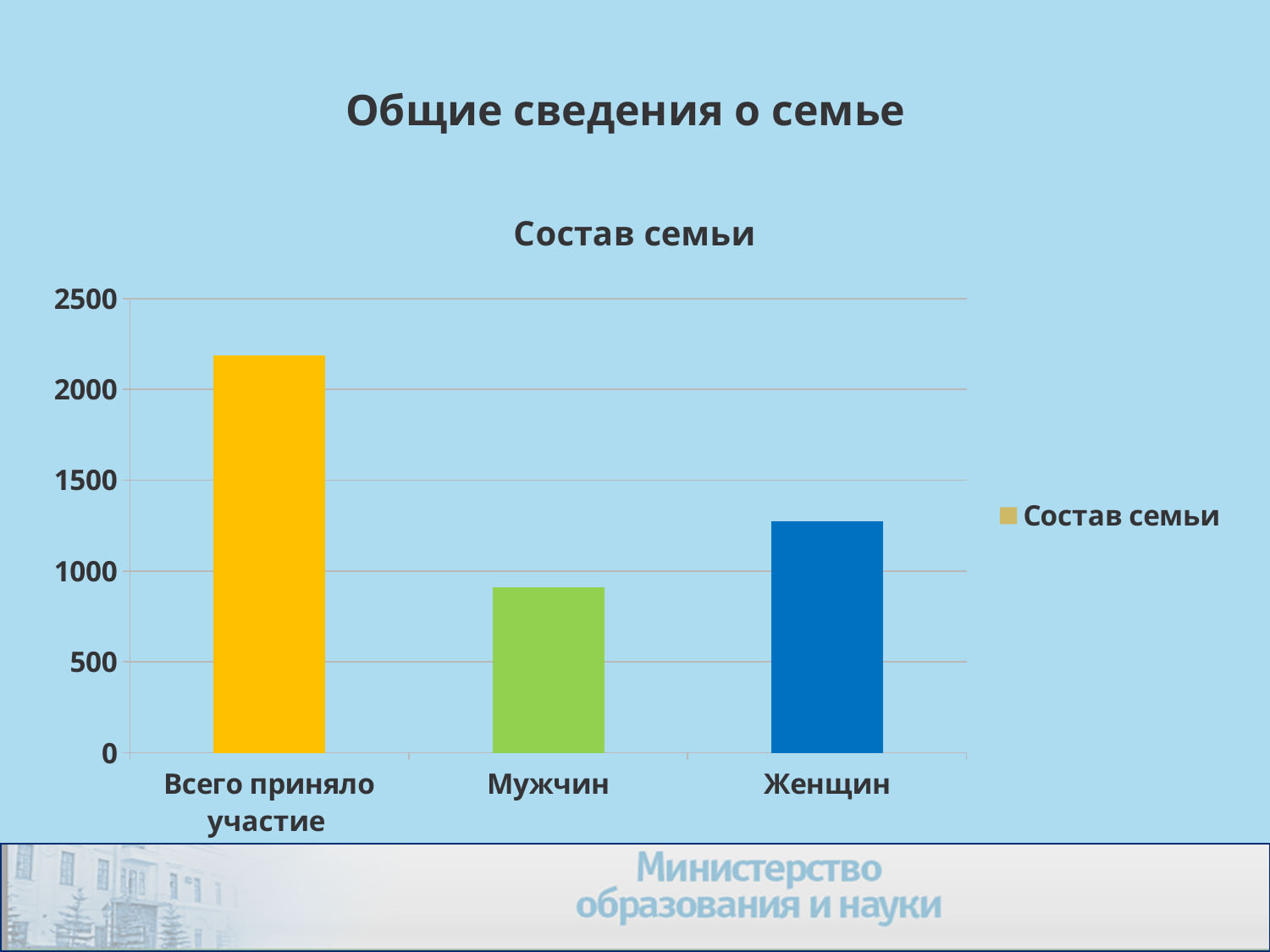
What kind of chart is shown on the slide? bar chart How many series does the legend list? 1 What is the title of the chart? Состав семьи Is the value for Женщин greater or less than 1000? greater What is the name of the series listed in the legend? Состав семьи Which is larger, the value for Мужчин or the value for Женщин? Женщин Is the value for Мужчин greater or less than 1000? less Which category has the lowest bar? Мужчин Is the value for Женщин greater or less than 1500? less Which category has the highest bar? Всего приняло участие How many categories are shown on the x axis of the chart? 3